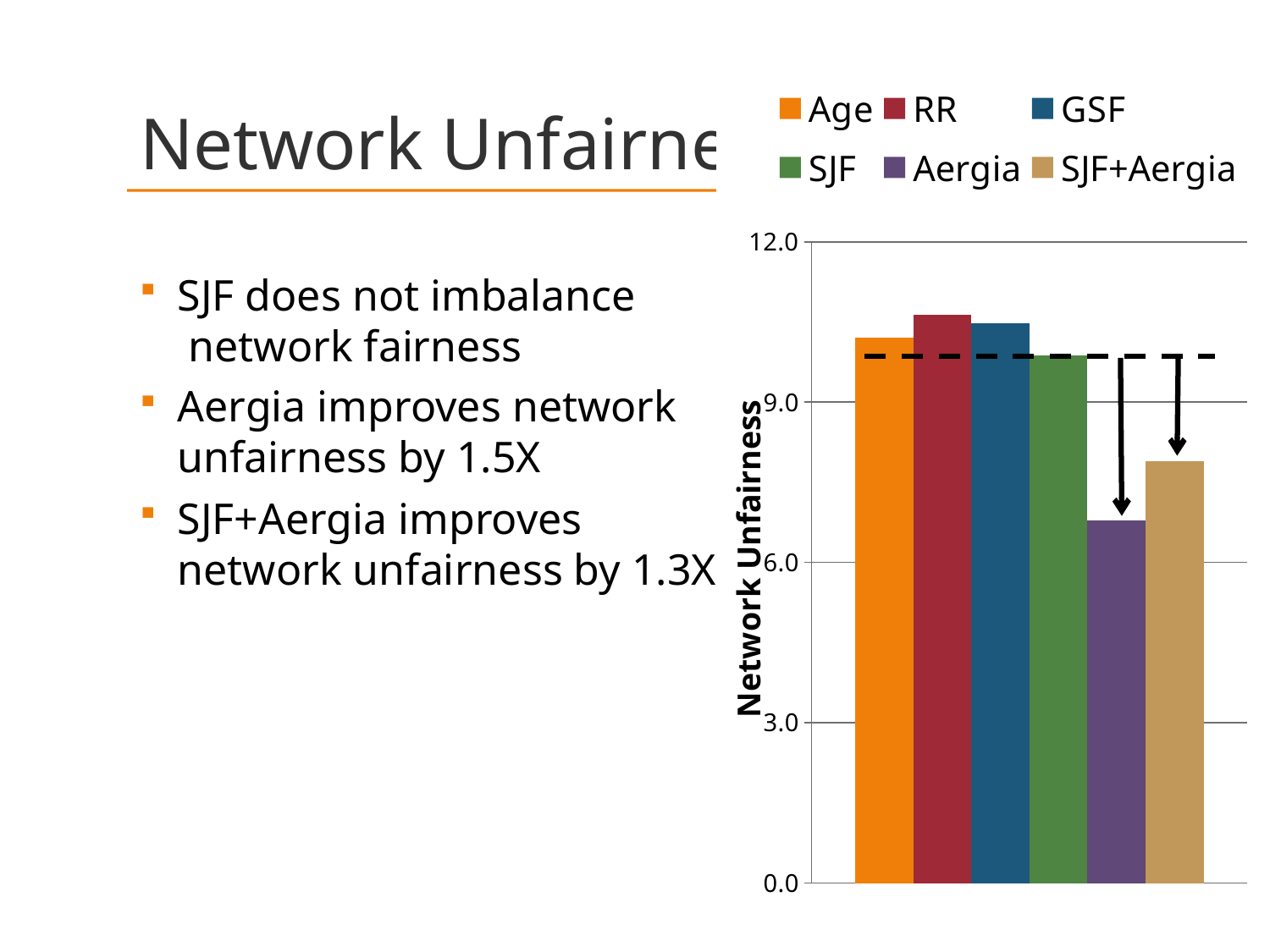
Is the Network Unfairness value for Age greater or less than 9.0? greater Which has a higher Network Unfairness, Aergia or SJF+Aergia? SJF+Aergia Is the Network Unfairness value for SJF+Aergia greater or less than 9.0? less Which series has the lowest Network Unfairness? Aergia How many series does the chart legend list? 6 Which series is shown in orange in the chart legend? Age Is the Network Unfairness value for RR greater or less than 12.0? less What is the label on the vertical axis of the chart? Network Unfairness How many bars are plotted in the chart? 6 What kind of chart is shown on the slide? bar chart Which has a higher Network Unfairness, GSF or Aergia? GSF